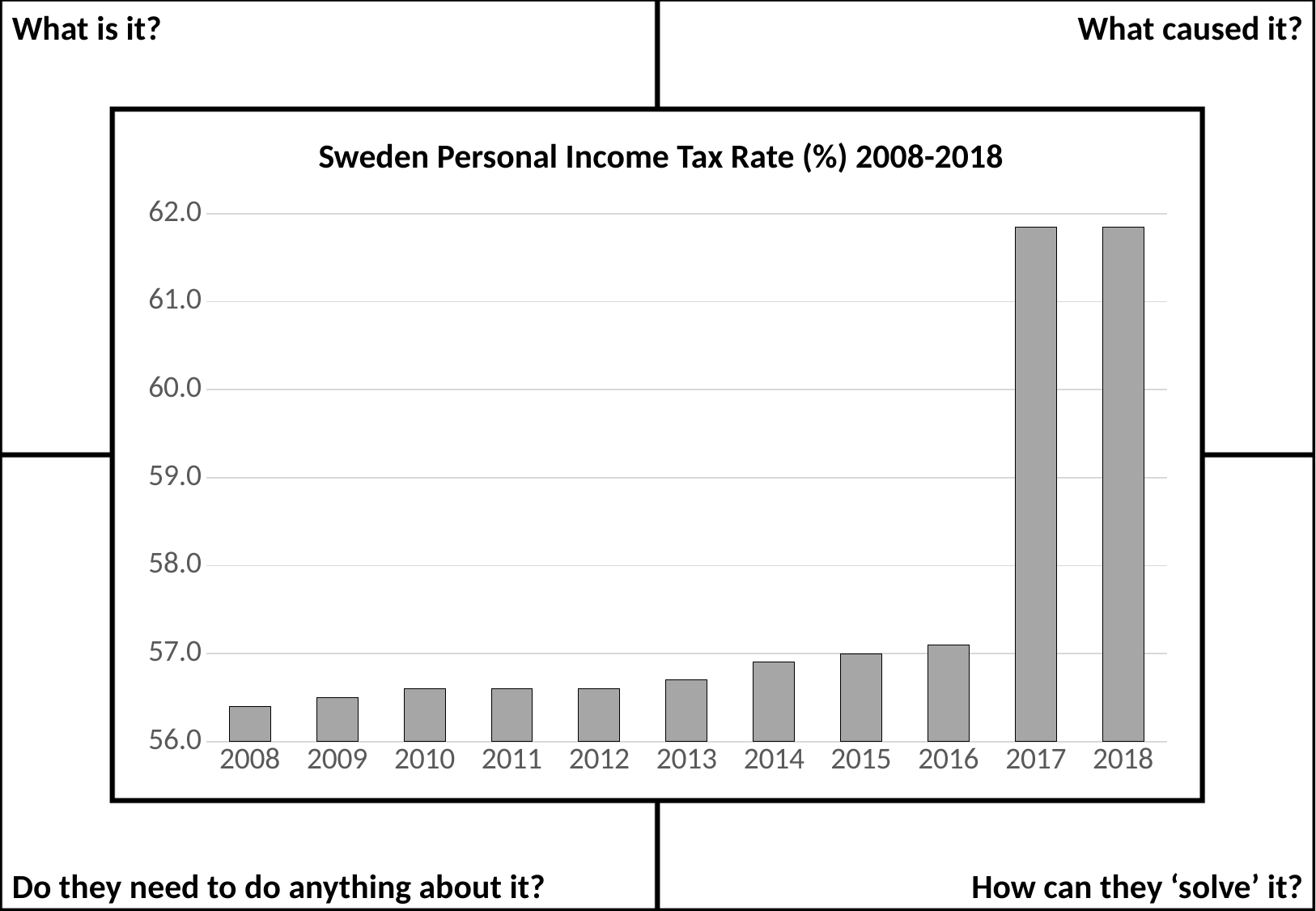
Which year has the lowest personal income tax rate? 2008 What colour are the bars in the chart? Grey How many years are plotted on the chart? 11 What kind of chart is shown on the slide? Bar chart Is the value for 2017 greater or less than 61.0? greater Is the value for 2008 greater or less than 57.0? less Do the values generally rise or fall from 2008 to 2018? rise Is the value for 2017 greater or less than 60.0? greater Which is larger, the value for 2017 or the value for 2016? 2017 What is the title of the chart? Sweden Personal Income Tax Rate (%) 2008-2018